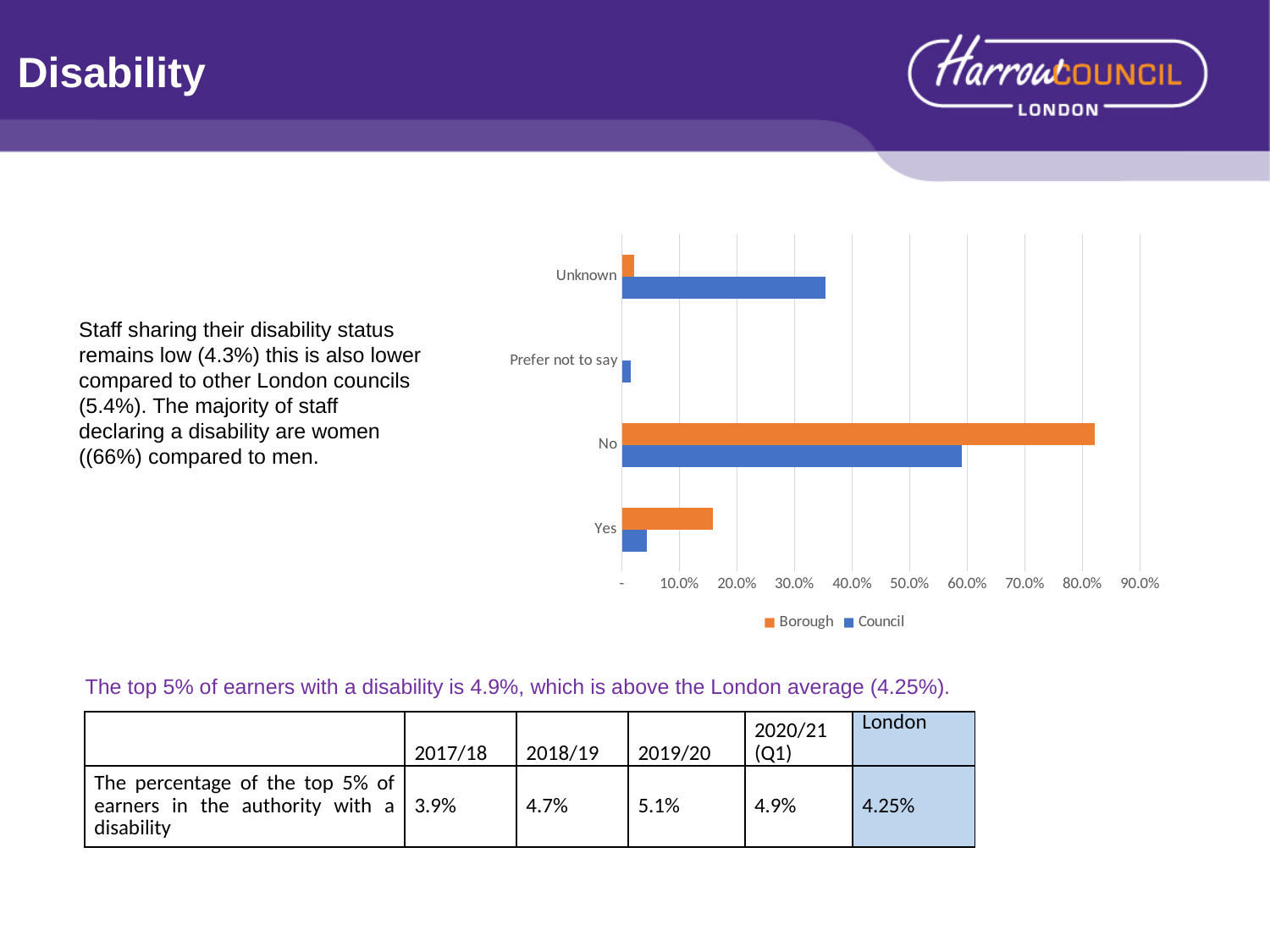
Is the Borough value for No greater or less than 70.0%? greater Which category has the lowest Council value? Prefer not to say Which category has the highest Borough value? No How many categories are shown on the chart's vertical axis? 4 Is the Council value for No greater or less than 50.0%? greater For the Unknown category, which series has the larger value, Borough or Council? Council For the Yes category, which series has the larger value, Borough or Council? Borough What colour are the Borough bars in the chart? orange Is the Council value for Yes greater or less than 10.0%? less Which category has the highest Council value? No How many series does the chart's legend list? 2 What kind of chart is shown on the slide? bar chart